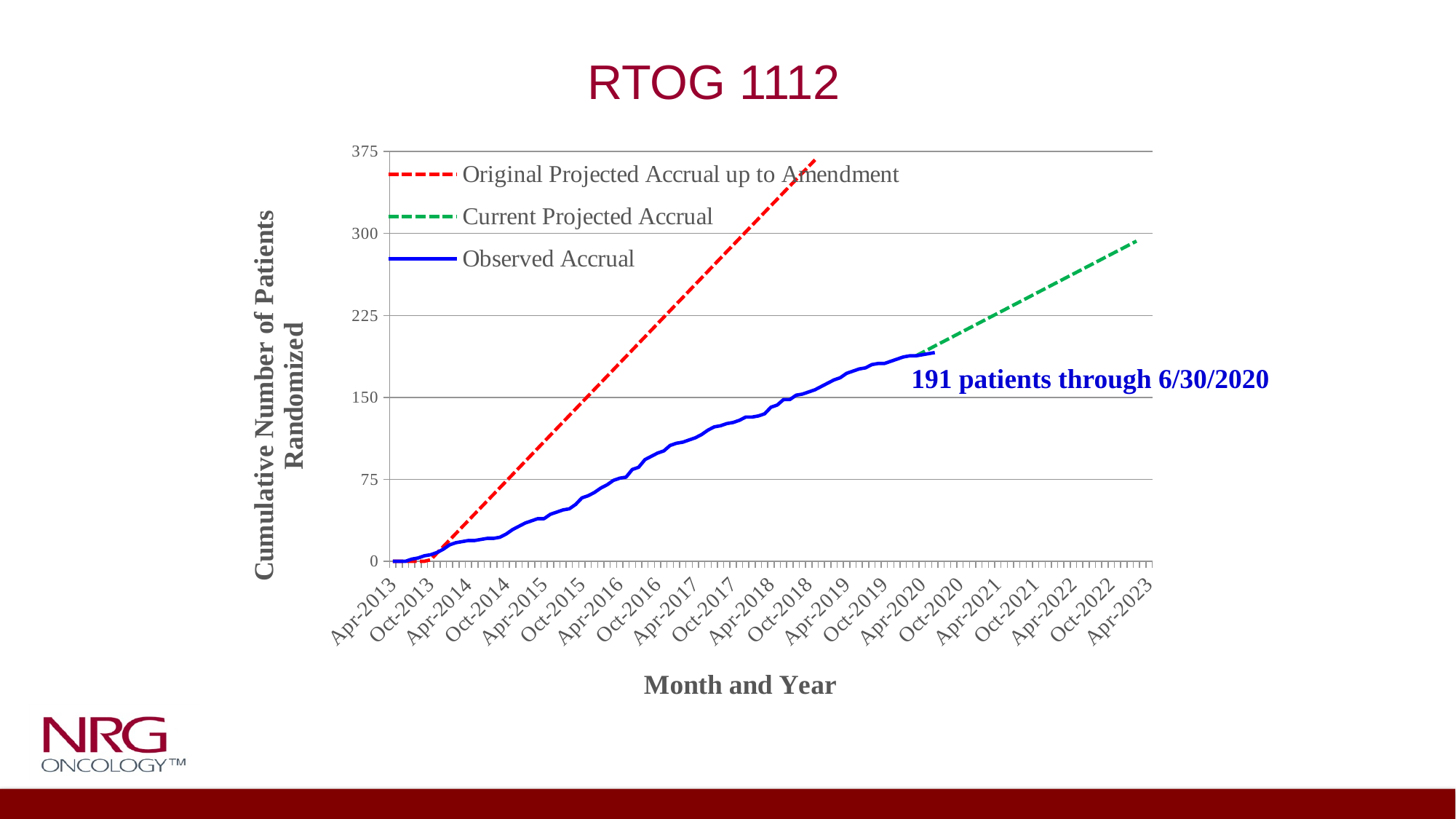
Is the Observed Accrual value at Apr-2017 greater or less than 150? less How many patients had been observed accrued through 6/30/2020? 191 patients Is the Original Projected Accrual up to Amendment value at Oct-2017 greater or less than 225? greater Is the Current Projected Accrual value at Oct-2022 greater or less than 225? greater How many month-year labels are shown on the x axis? 21 At Apr-2018, which is higher: Original Projected Accrual up to Amendment or Observed Accrual? Original Projected Accrual up to Amendment Does the Observed Accrual line rise or fall from Apr-2013 to Apr-2020? rise What is the title of the chart? RTOG 1112 How many series does the legend list? 3 What type of chart is shown on the slide? line chart What colour is the Observed Accrual line? blue